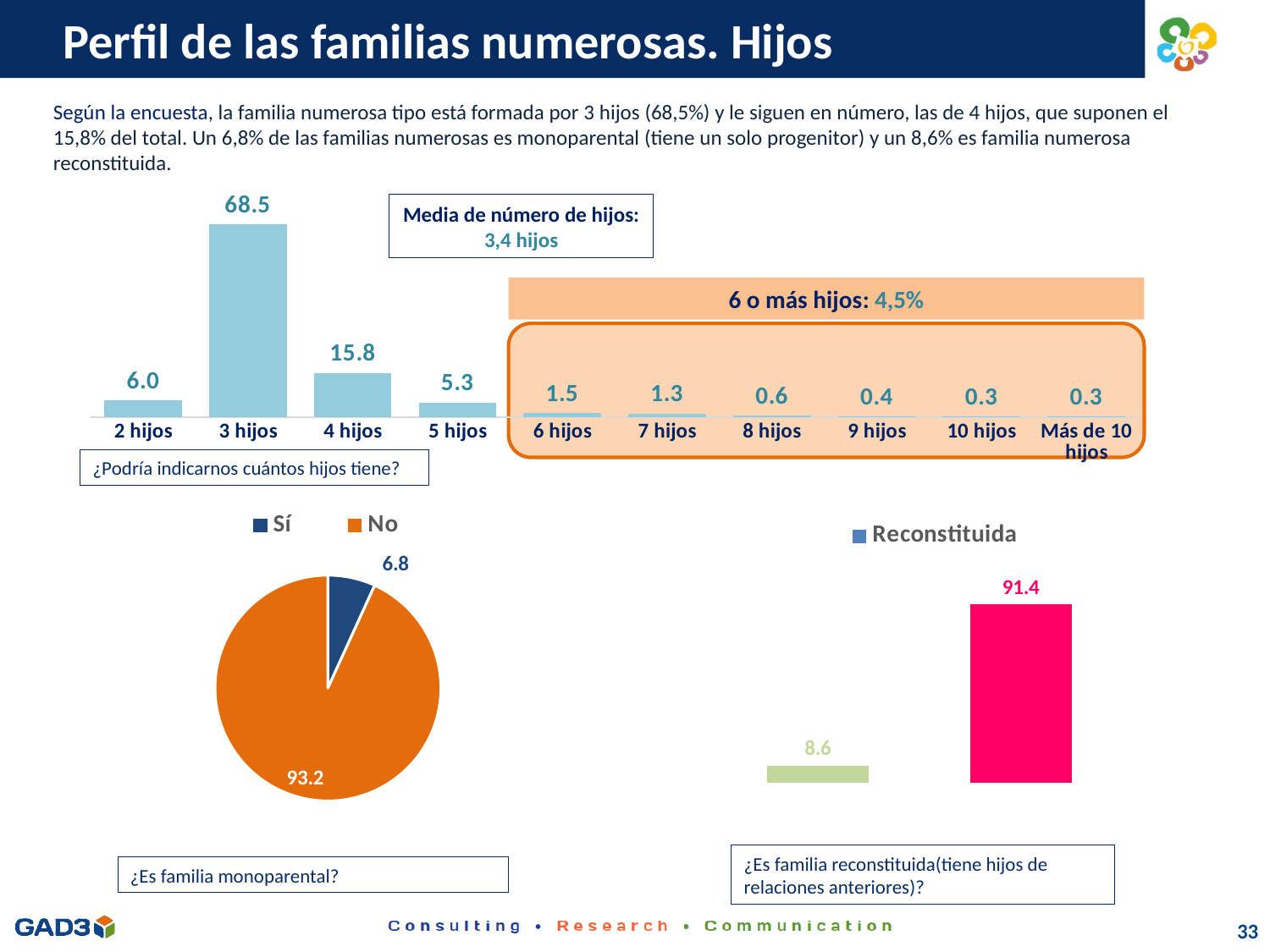
What kind of chart is the bottom-left chart (¿Es familia monoparental?)? pie chart In the top bar chart (¿Podría indicarnos cuántos hijos tiene?), which category has the highest value? 3 hijos In the pie chart (¿Es familia monoparental?), what is the value for Sí? 6.8 In the top bar chart (¿Podría indicarnos cuántos hijos tiene?), what is the difference between the values for 2 hijos and 5 hijos? 0.7 In the bottom-right bar chart (¿Es familia reconstituida?), what is the difference between the two bar values? 82.8 In the top bar chart (¿Podría indicarnos cuántos hijos tiene?), which is larger, the value for 6 hijos or the value for 7 hijos? 6 hijos How many categories are shown on the x axis of the top bar chart (¿Podría indicarnos cuántos hijos tiene?)? 10 In the pie chart (¿Es familia monoparental?), what is the value for No? 93.2 In the top bar chart (¿Podría indicarnos cuántos hijos tiene?), what is the value for 3 hijos? 68.5 In the top bar chart (¿Podría indicarnos cuántos hijos tiene?), what is the value for 4 hijos? 15.8 In the top bar chart (¿Podría indicarnos cuántos hijos tiene?), what is the value for 8 hijos? 0.6 In the top bar chart (¿Podría indicarnos cuántos hijos tiene?), do the values rise or fall from 3 hijos to Más de 10 hijos? fall